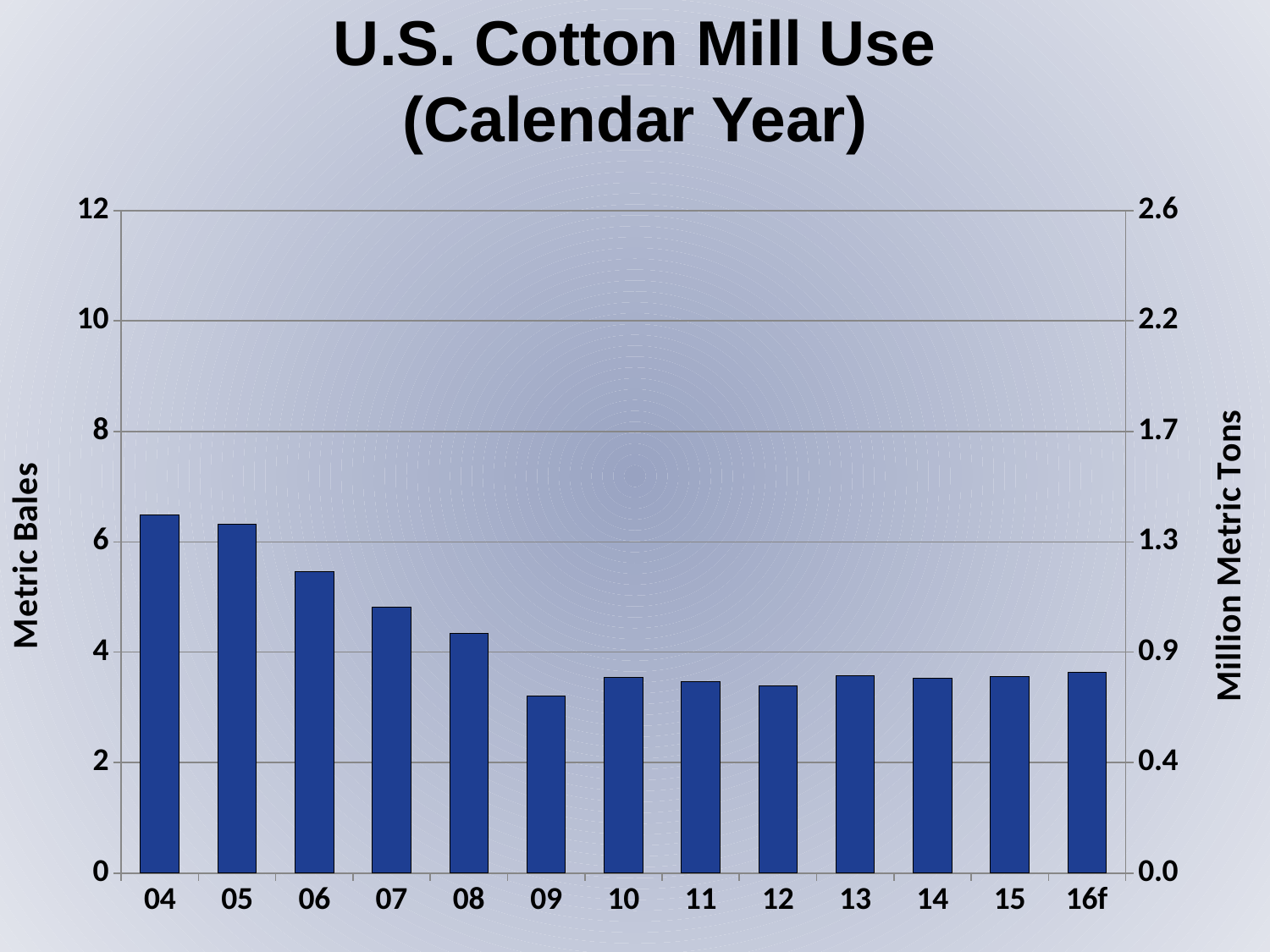
What is the title of the chart? U.S. Cotton Mill Use (Calendar Year) Which is larger, the value for 06 or the value for 08? 06 Which year has the lowest cotton mill use? 09 How many years (categories) are plotted on the x axis? 13 What is the label of the right-hand vertical axis? Million Metric Tons Which year has the highest cotton mill use? 04 Is the value for 04 greater or less than 6 on the Metric Bales axis? greater Is the value for 08 greater or less than 4 on the Metric Bales axis? greater What kind of chart is shown on the slide? bar chart Do the values rise or fall from 04 to 09? fall Is the value for 09 greater or less than 4 on the Metric Bales axis? less